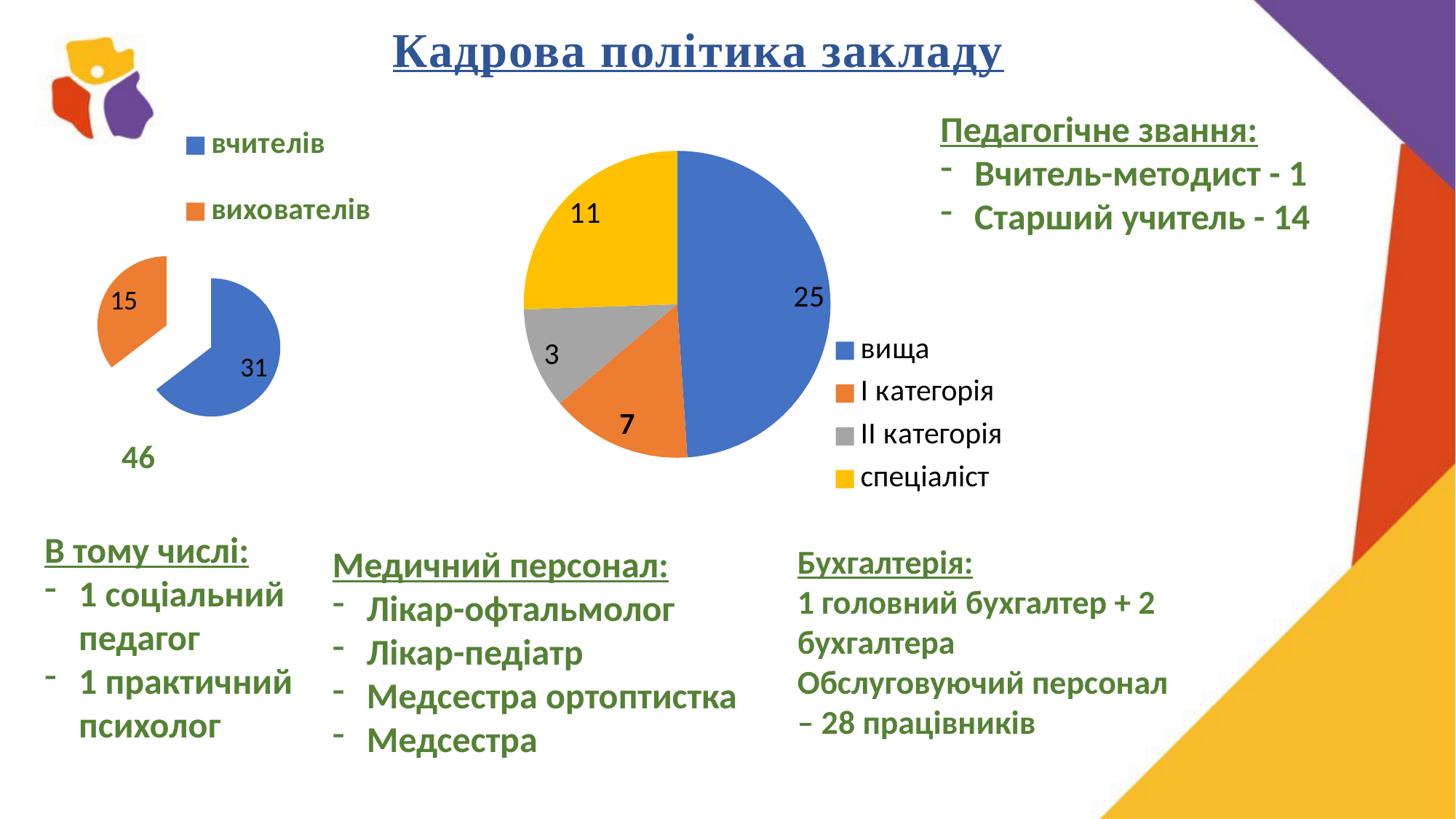
How many categories does the legend of the right pie chart list? 4 What type of chart is the left chart on the slide? pie chart In the right pie chart, which is larger: спеціаліст or I категорія? спеціаліст In the right pie chart, what is the difference between вища and спеціаліст? 14 In the right pie chart, which category has the smallest slice? II категорія In the left pie chart, what is the difference between вчителів and вихователів? 16 In the right pie chart, which category has the largest slice? вища In the left pie chart, what is the value for вчителів? 31 In the right pie chart, what is the value for II категорія? 3 In the left pie chart, what is the value for вихователів? 15 In the left pie chart, what is the total of the two slices? 46 In the right pie chart, what is the value for вища? 25